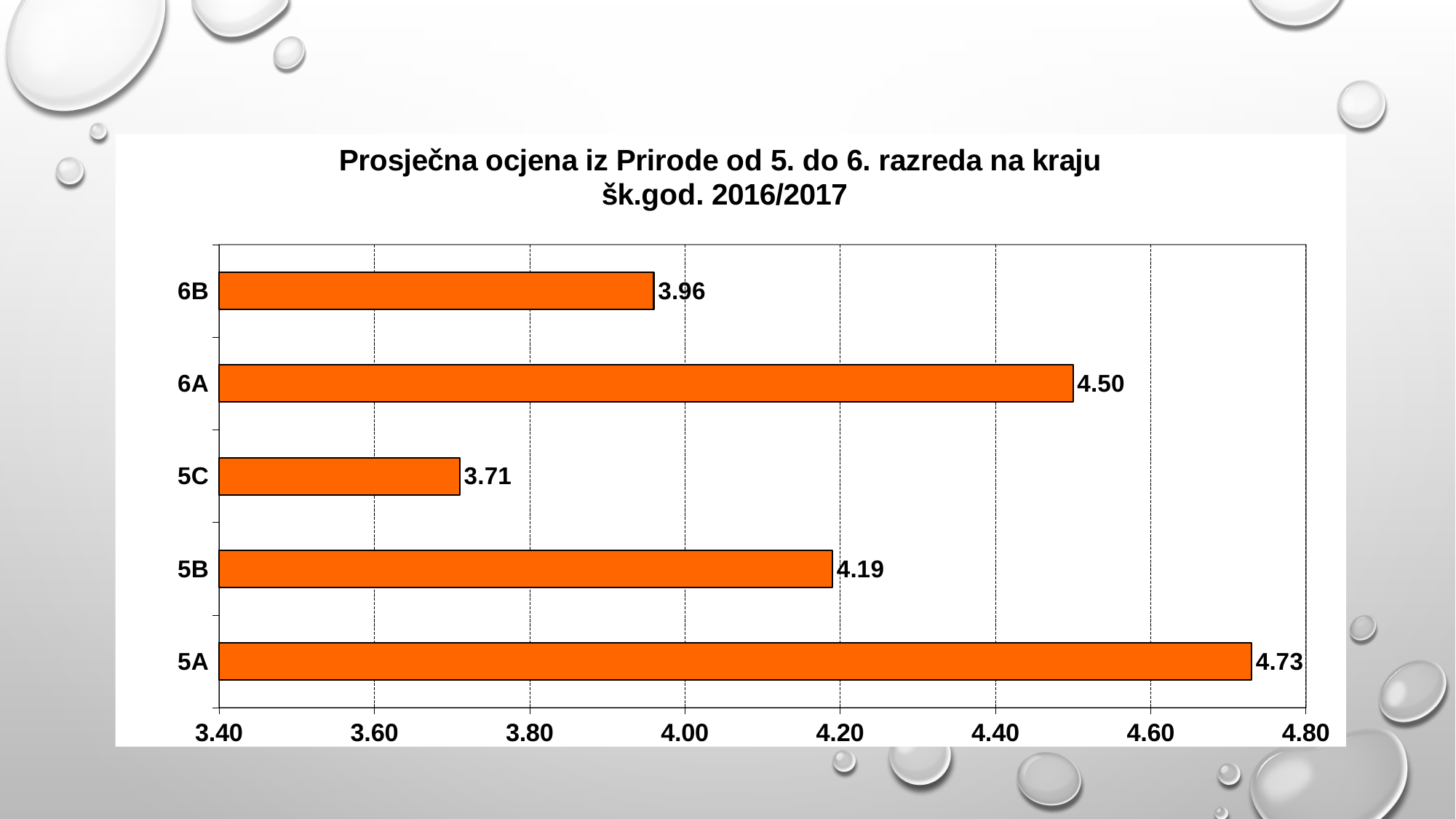
What is the difference between the average grades of 6A and 6B? 0.54 How many classes are shown in the chart? 5 What kind of chart is shown on the slide? Bar chart What is the average grade for class 5C? 3.71 Which class has the lowest average grade? 5C What is the average grade for class 6B? 3.96 Which class has a higher average grade, 5B or 6A? 6A Which class has the highest average grade? 5A What is the average grade for class 5A? 4.73 What colour are the bars in the chart? Orange What is the difference between the average grades of 5A and 5C? 1.02 Is the value for 5B greater or less than 4.00? greater